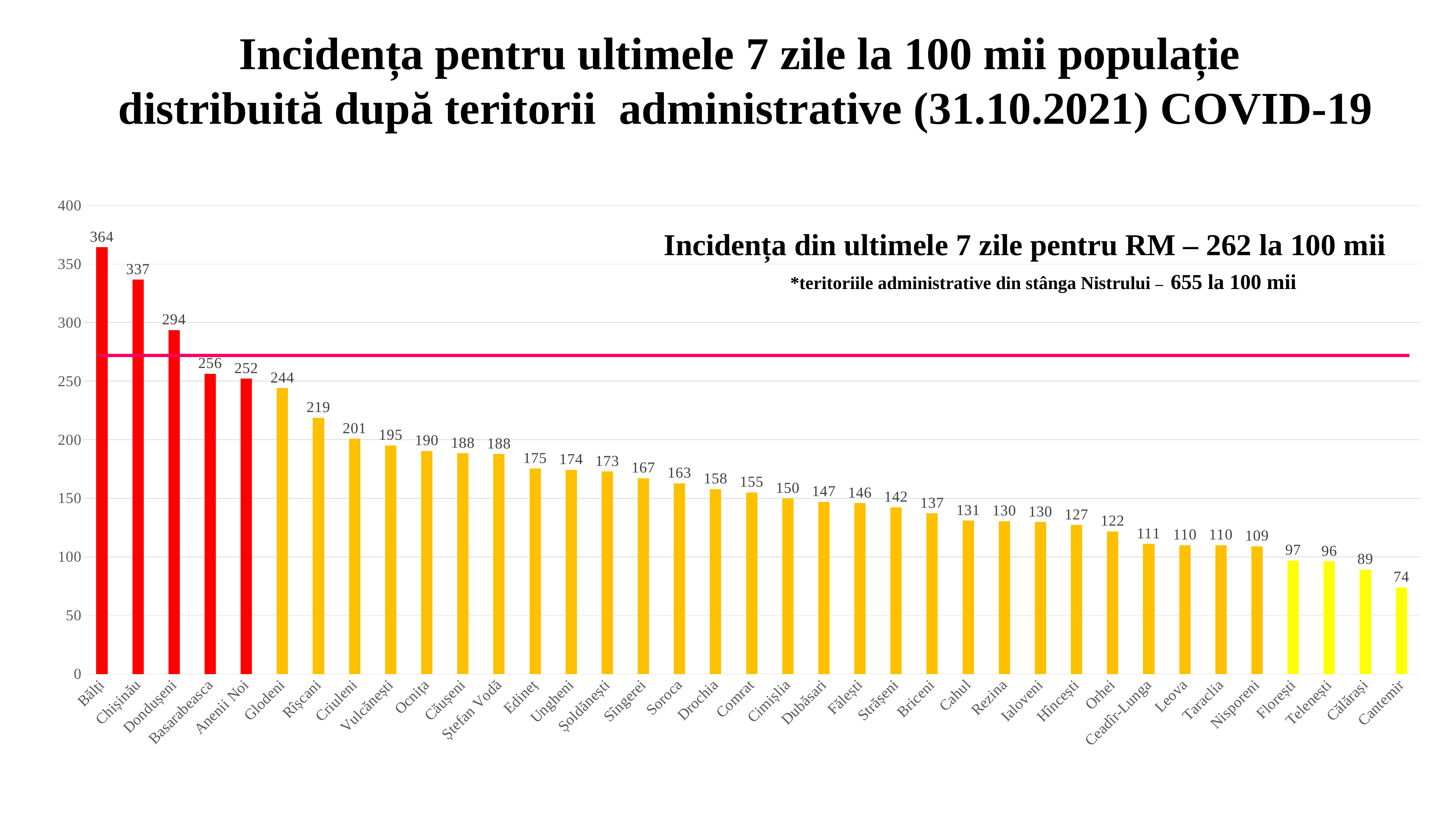
What is the incidence value shown for Cahul? 131 How many territories are shown on the chart? 37 Do the values rise or fall from left to right along the x axis? Fall What kind of chart is shown on the slide? Bar chart What is the difference between the incidence values for Bălți and Chișinău? 27 Which territory has the highest incidence on the chart? Bălți Which has a higher incidence, Dondușeni or Anenii Noi? Dondușeni What is the incidence value shown for Soroca? 163 What is the incidence value shown for Chișinău? 337 Which territory has the lowest incidence on the chart? Cantemir Which has a higher incidence, Orhei or Leova? Orhei What is the difference between the incidence values for Glodeni and Florești? 147